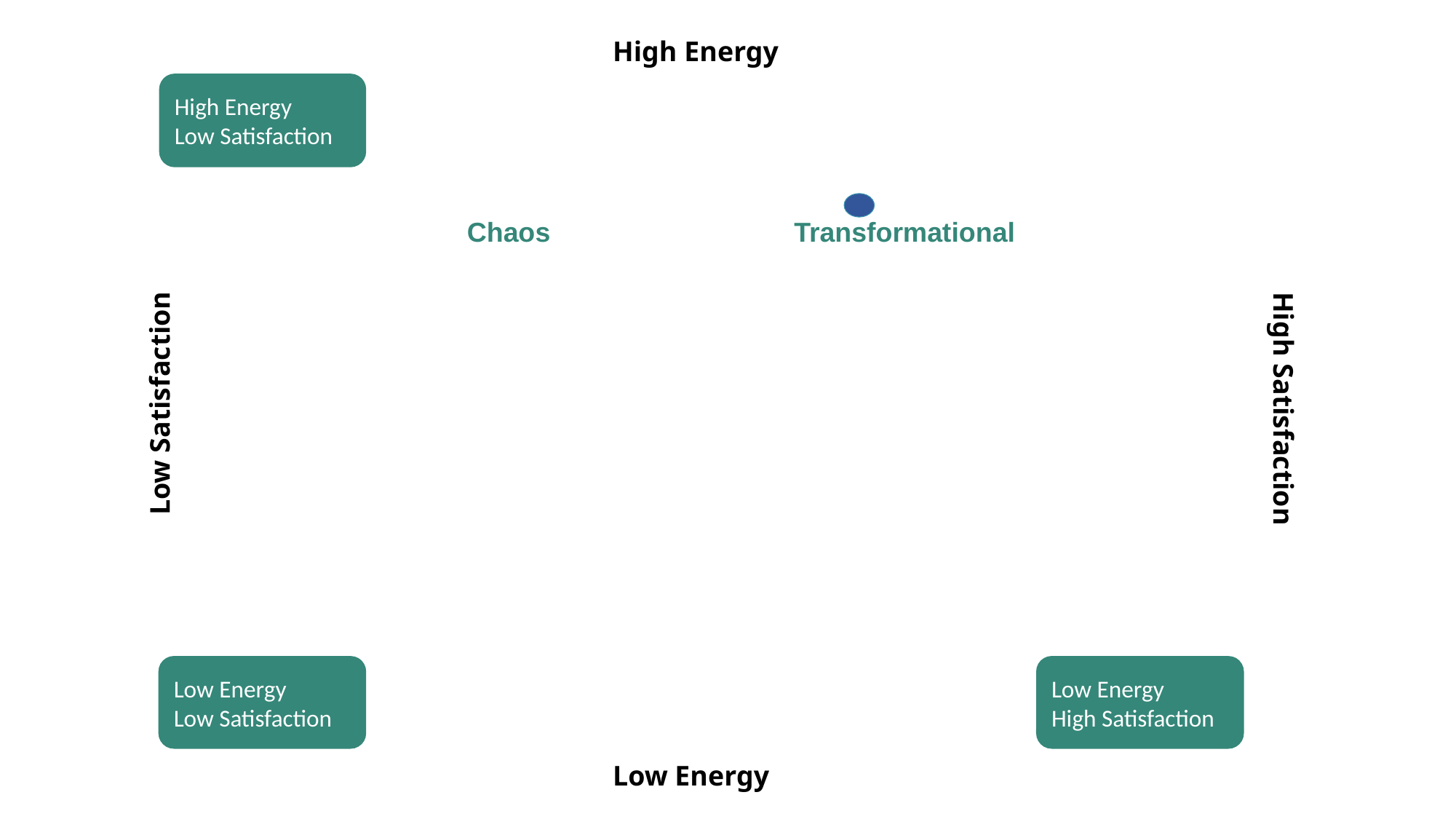
Is the plotted blue dot in the High Energy half or the Low Energy half of the chart? High Energy What label is shown at the top of the chart? High Energy Is the plotted blue dot on the Low Satisfaction side or the High Satisfaction side of the chart? High Satisfaction How many data points are plotted on the quadrant chart? 1 Which quadrant label is the blue dot positioned next to? Transformational